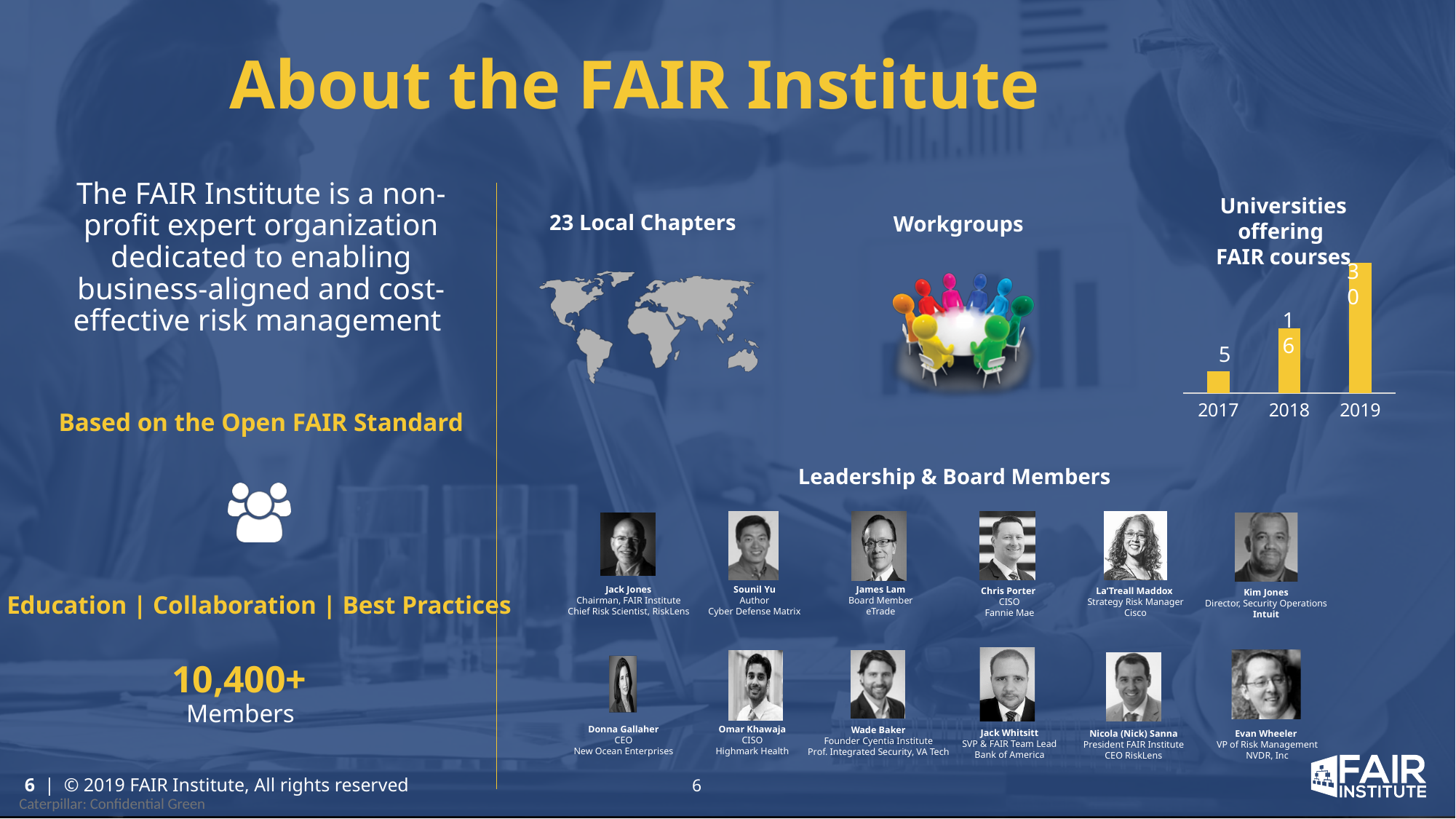
In the "Universities offering FAIR courses" chart, do the values rise or fall from 2017 to 2019? rise In the "Universities offering FAIR courses" chart, which year has the lowest value? 2017 What kind of chart is shown under "Universities offering FAIR courses"? bar chart In the "Universities offering FAIR courses" chart, what is the value for 2017? 5 In the "Universities offering FAIR courses" chart, what is the value for 2019? 30 What is the title of the bar chart on the slide? Universities offering FAIR courses In the "Universities offering FAIR courses" chart, which is larger, the value for 2017 or the value for 2018? 2018 In the "Universities offering FAIR courses" chart, what is the difference between the 2019 and 2018 values? 14 How many years are shown in the "Universities offering FAIR courses" chart? 3 In the "Universities offering FAIR courses" chart, which year has the highest value? 2019 In the "Universities offering FAIR courses" chart, what is the difference between the 2018 and 2017 values? 11 In the "Universities offering FAIR courses" chart, what is the value for 2018? 16